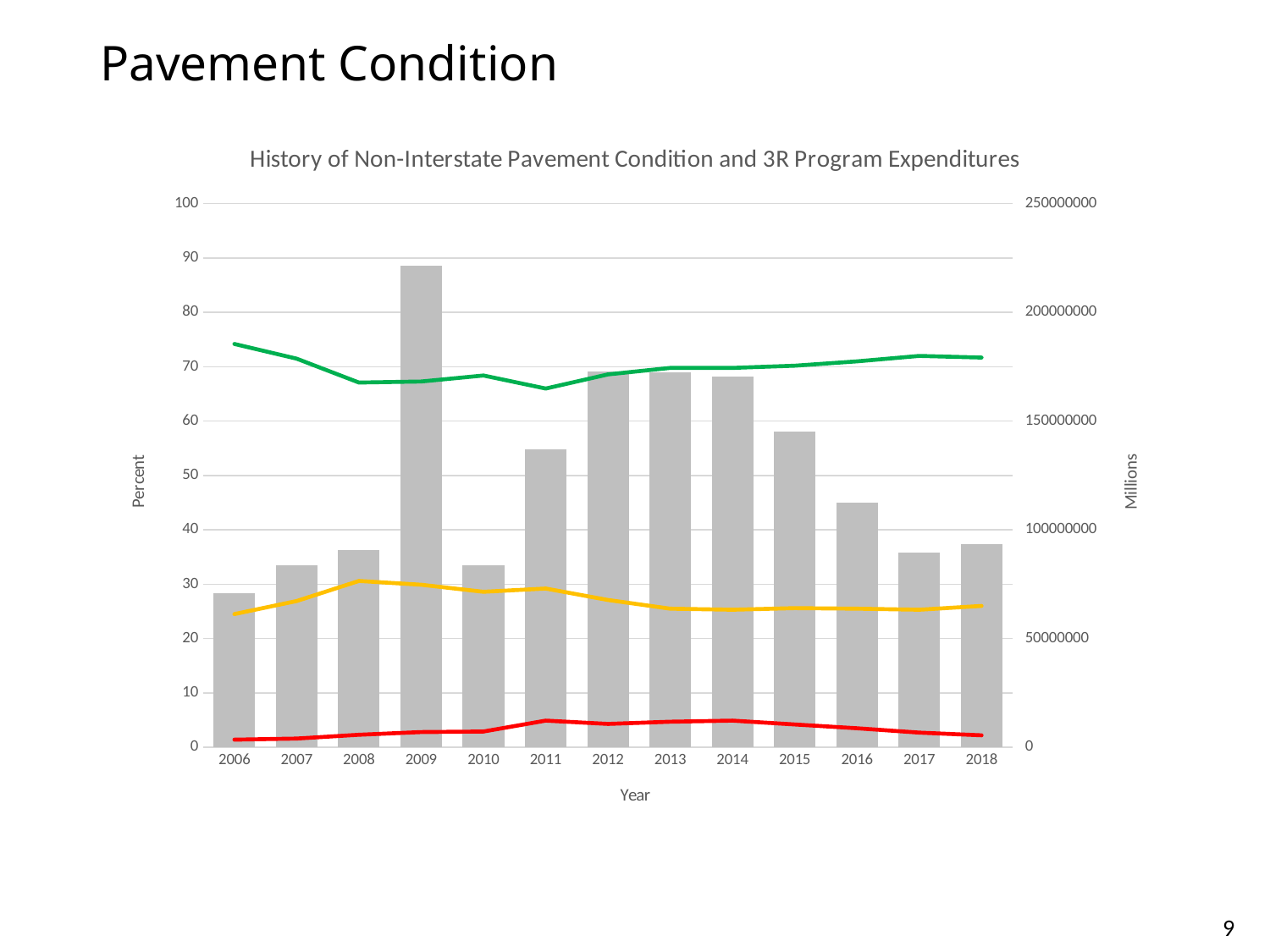
In which year is the gray bar the shortest? 2006 In which year is the gray bar the tallest? 2009 What kind of chart is shown on the slide? A combination bar and line chart Do the gray bars rise or fall from 2013 to 2017? fall In which year does the yellow line reach its highest point? 2008 Is the gray bar for 2006 greater or less than 100000000 on the right axis? less Is the gray bar for 2009 greater or less than 200000000 on the right axis? greater What is the title of the chart? History of Non-Interstate Pavement Condition and 3R Program Expenditures How many years are shown along the x axis of the chart? 13 Is the yellow line's value for 2013 greater or less than 30 on the left axis? less Which year has the taller gray bar, 2015 or 2016? 2015